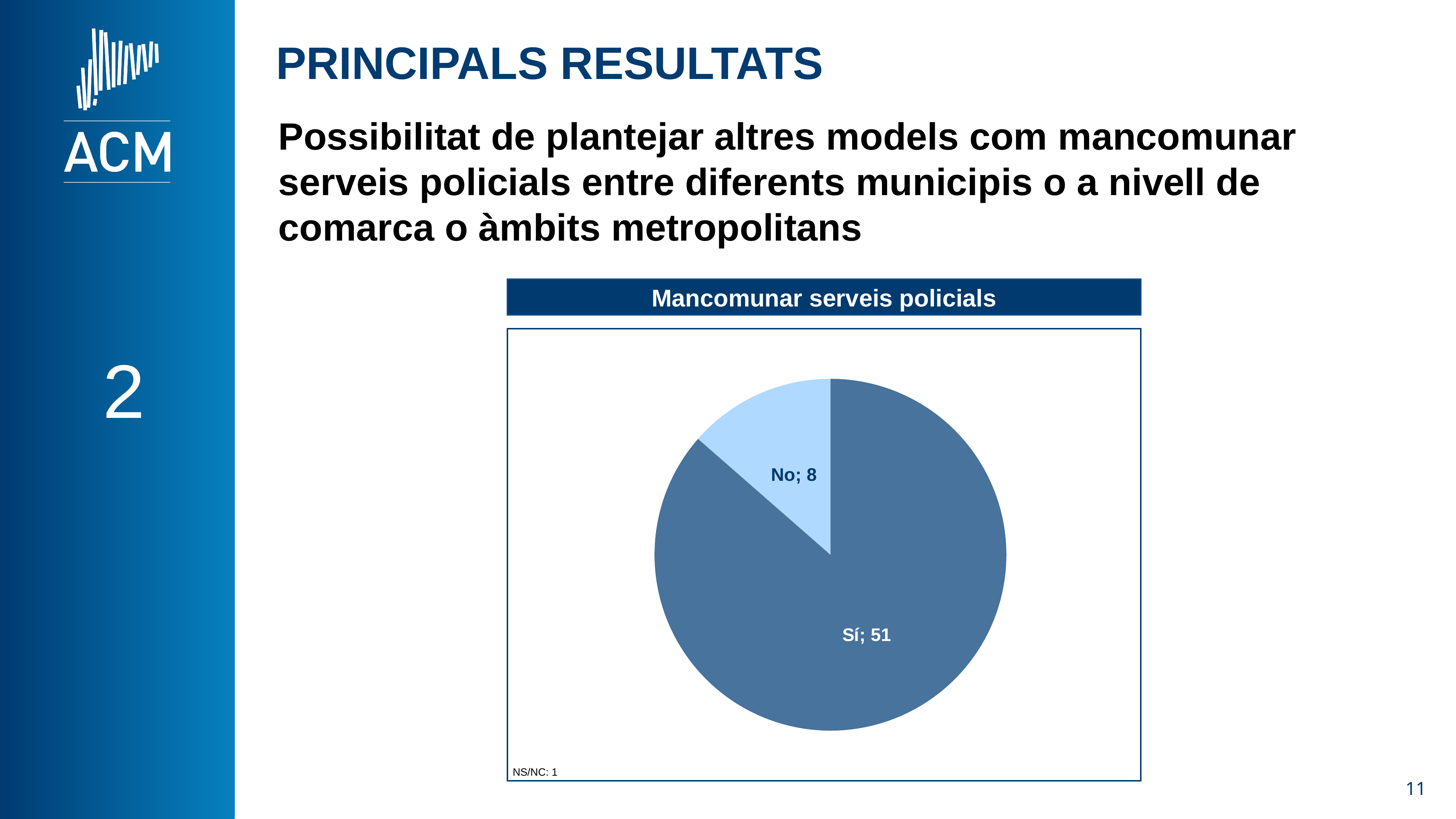
Which category has the largest slice in the pie chart? Sí Which category has the smallest slice in the pie chart? No What is the value for Sí in the pie chart? 51 What is the total of the Sí and No values shown in the pie chart? 59 What kind of chart is shown on the slide? Pie chart What is the title of the chart? Mancomunar serveis policials How many slices does the pie chart have? 2 What is the value for No in the pie chart? 8 What value is given for NS/NC in the note below the pie chart? 1 Which is larger in the pie chart, Sí or No? Sí What is the difference between the Sí and No values in the pie chart? 43